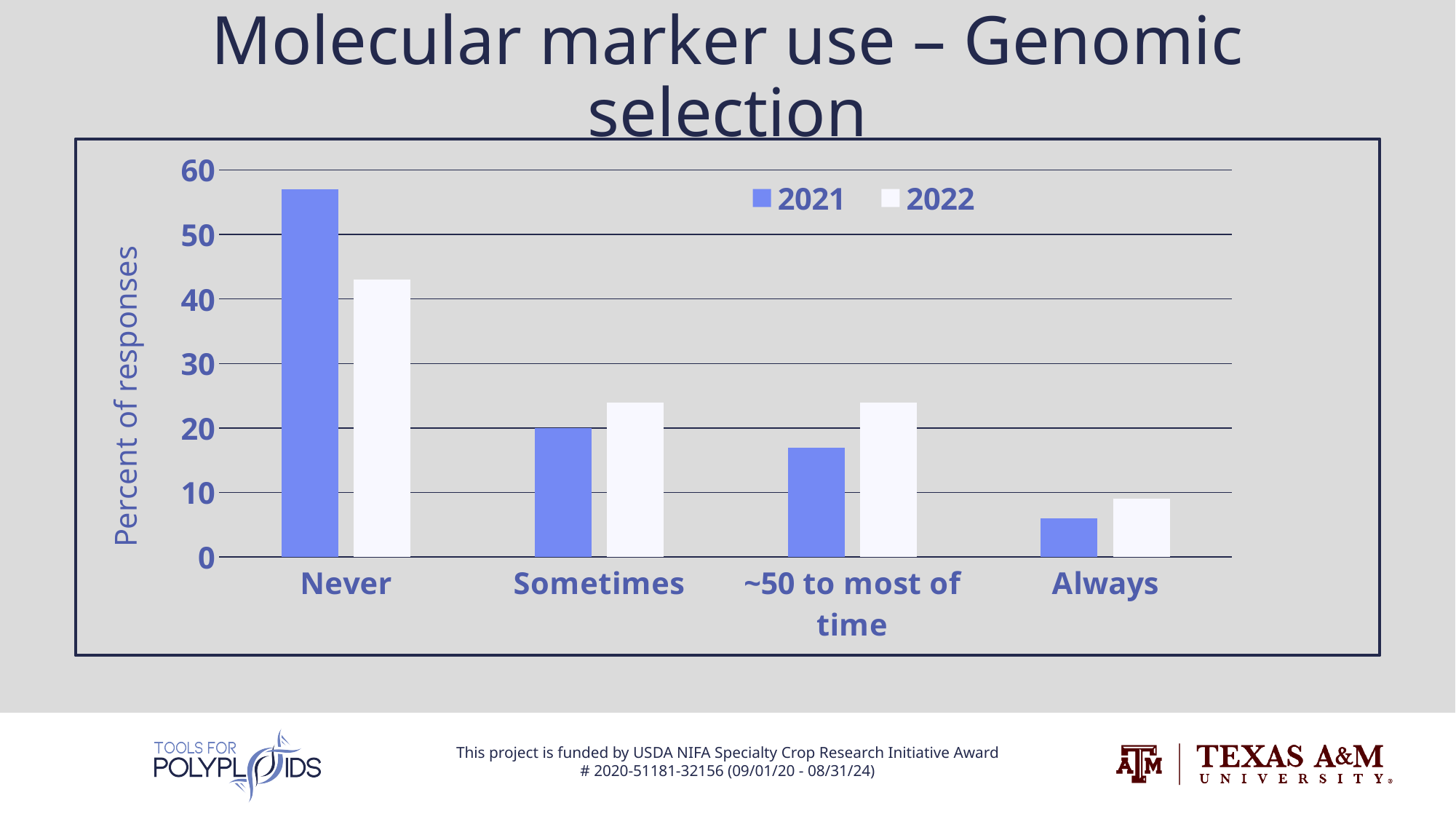
Is the 2022 value for Never greater or less than 40? greater What kind of chart is shown on the slide? bar chart Is the 2021 value for Always greater or less than 10? less Which category has the highest bar in the chart? Never How many categories are shown on the x axis? 4 Which category has the lowest bar for 2021? Always How many series does the legend list? 2 What is the label on the vertical axis? Percent of responses Is the 2021 value for Never greater or less than 50? greater For the Never category, which year has the larger value, 2021 or 2022? 2021 Do the 2021 values rise or fall moving from Never to Always along the x axis? fall